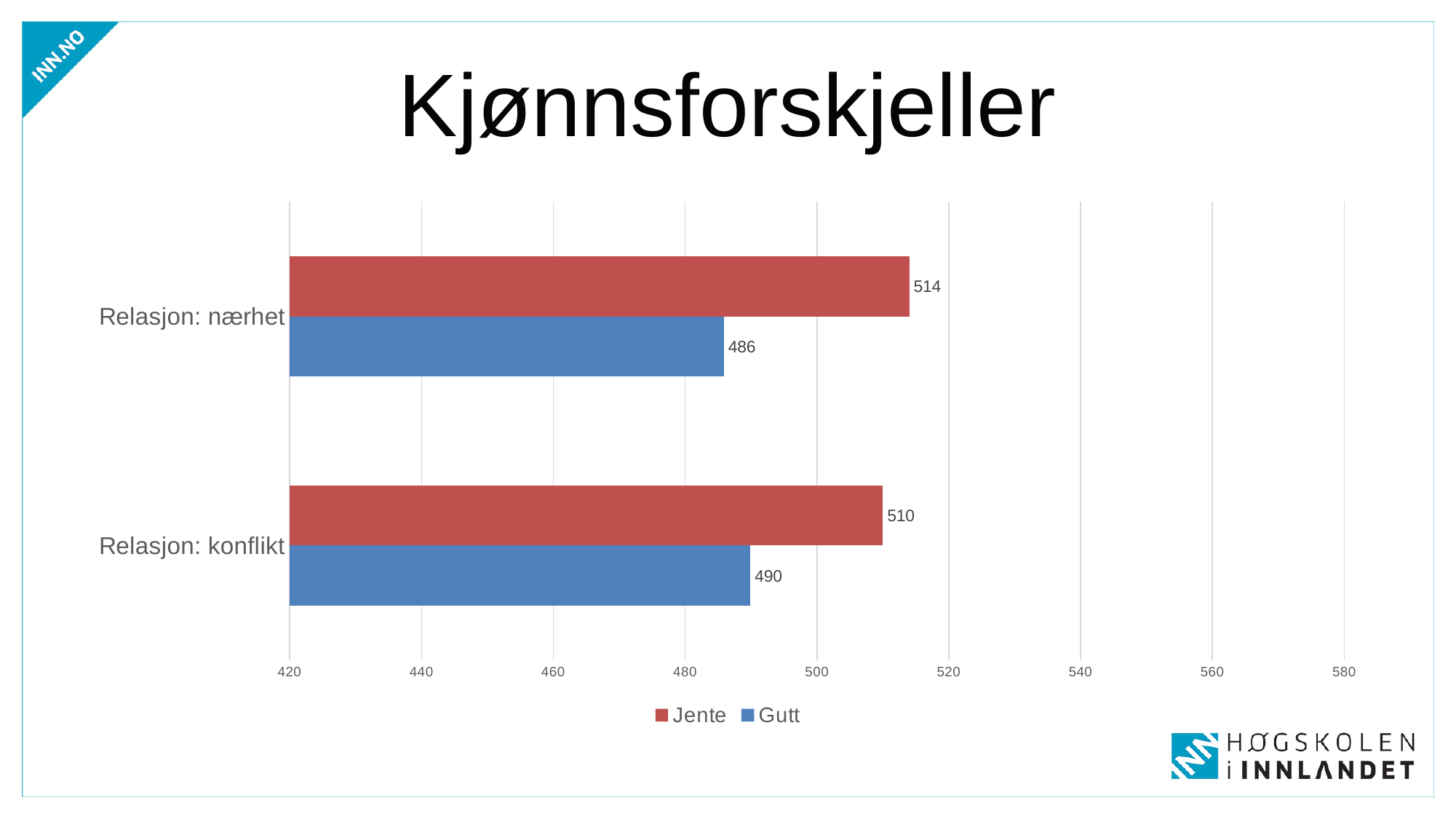
Is the value for Gutt in Relasjon: nærhet greater or less than 500? less What is the value for Jente in the Relasjon: nærhet category? 514 Which series has the highest value in the Relasjon: nærhet category? Jente What kind of chart is shown on the slide? bar chart What is the value for Gutt in the Relasjon: konflikt category? 490 How many series does the legend list? 2 What is the difference between the Jente and Gutt values for Relasjon: nærhet? 28 What is the value for Gutt in the Relasjon: nærhet category? 486 Which is larger for Relasjon: konflikt, Jente or Gutt? Jente What is the value for Jente in the Relasjon: konflikt category? 510 Which bar has the lowest value on the chart? Gutt, Relasjon: nærhet What is the difference between the Jente and Gutt values for Relasjon: konflikt? 20